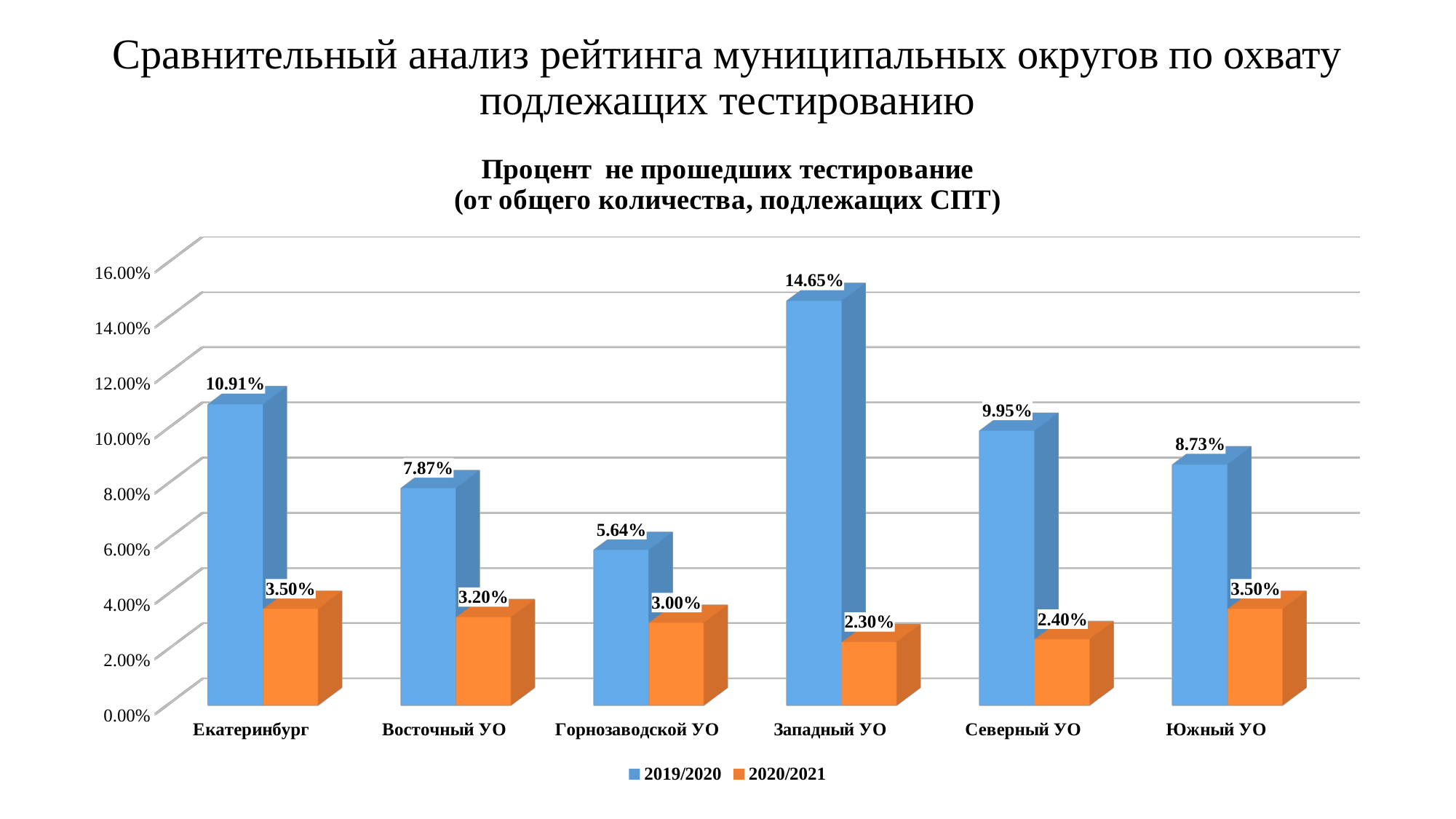
What kind of chart is shown? bar chart What is the difference between the 2019/2020 and 2020/2021 values for Северный УО? 7.55% Which is larger: the 2019/2020 value for Восточный УО or the 2019/2020 value for Южный УО? Южный УО What is the 2020/2021 value for Горнозаводской УО? 3.00% Which category has the lowest 2019/2020 value? Горнозаводской УО What is the 2019/2020 value for Екатеринбург? 10.91% How many series does the legend list? 2 Which category has the lowest 2020/2021 value? Западный УО What is the title of the chart? Процент не прошедших тестирование (от общего количества, подлежащих СПТ) Which category has the highest 2019/2020 value? Западный УО How many categories are shown on the x axis? 6 What is the 2019/2020 value for Западный УО? 14.65%